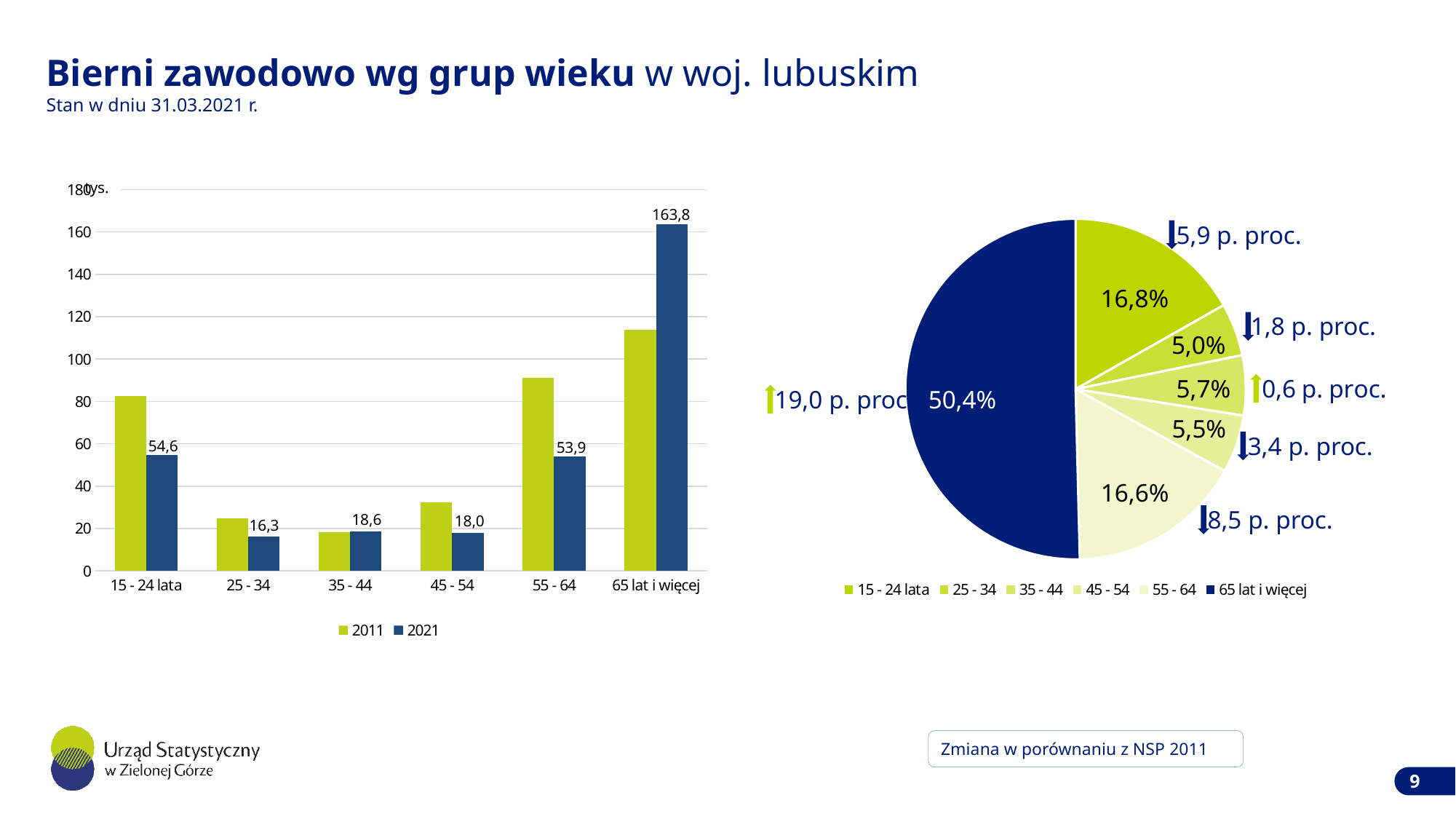
What kind of chart is shown on the left of the slide? bar chart In the bar chart on the left, is the 2011 value for 25 - 34 greater or less than 40? less In the bar chart on the left, which age group has the lowest 2021 value? 25 - 34 In the bar chart on the left, what is the 2021 value for the 15 - 24 lata age group? 54,6 In the bar chart on the left, how many series does the legend list? 2 In the pie chart on the right, which age group has the smallest slice? 25 - 34 In the bar chart on the left, how many age groups are shown on the x axis? 6 In the bar chart on the left, is the 2011 value for 55 - 64 greater or less than 80? greater In the bar chart on the left, what is the difference between the 2021 values for 15 - 24 lata and 55 - 64? 0,7 In the bar chart on the left, what is the 2021 value for the 65 lat i więcej age group? 163,8 In the pie chart on the right, what share does the 65 lat i więcej group have? 50,4% In the bar chart on the left, which age group has the highest 2021 value? 65 lat i więcej